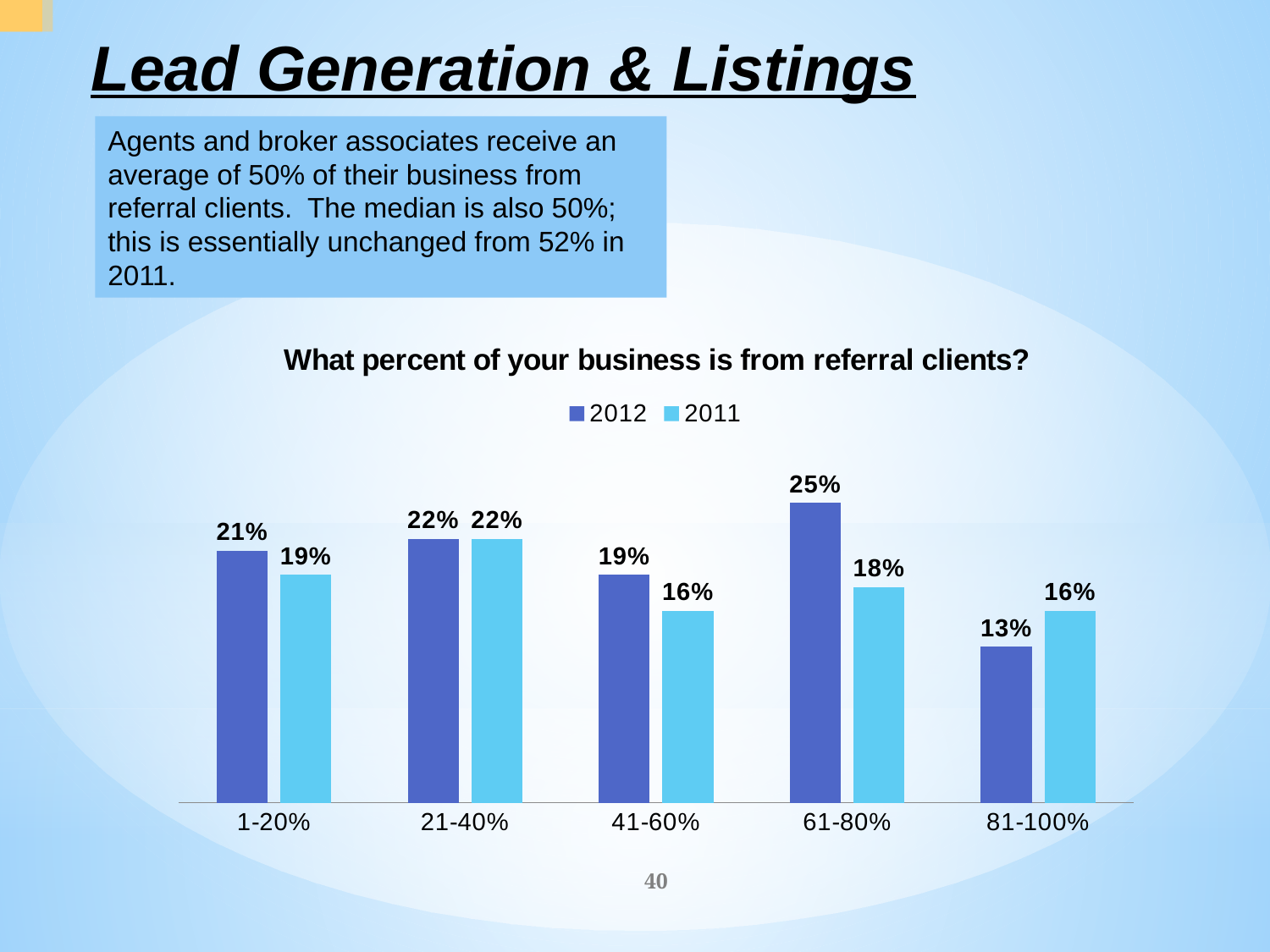
How many categories are shown on the x axis? 5 Which category has the highest 2012 value? 61-80% Which category has the highest 2011 value? 21-40% Which category has the lowest 2012 value? 81-100% What is the 2012 value for the 81-100% category? 13% What is the 2011 value for the 41-60% category? 16% What kind of chart is shown on the slide? Bar chart How many series does the legend list? 2 Which is larger for the 81-100% category, the 2012 value or the 2011 value? 2011 What is the 2012 value for the 61-80% category? 25% What is the difference between the 2012 and 2011 values for the 61-80% category? 7% What is the title of the chart? What percent of your business is from referral clients?